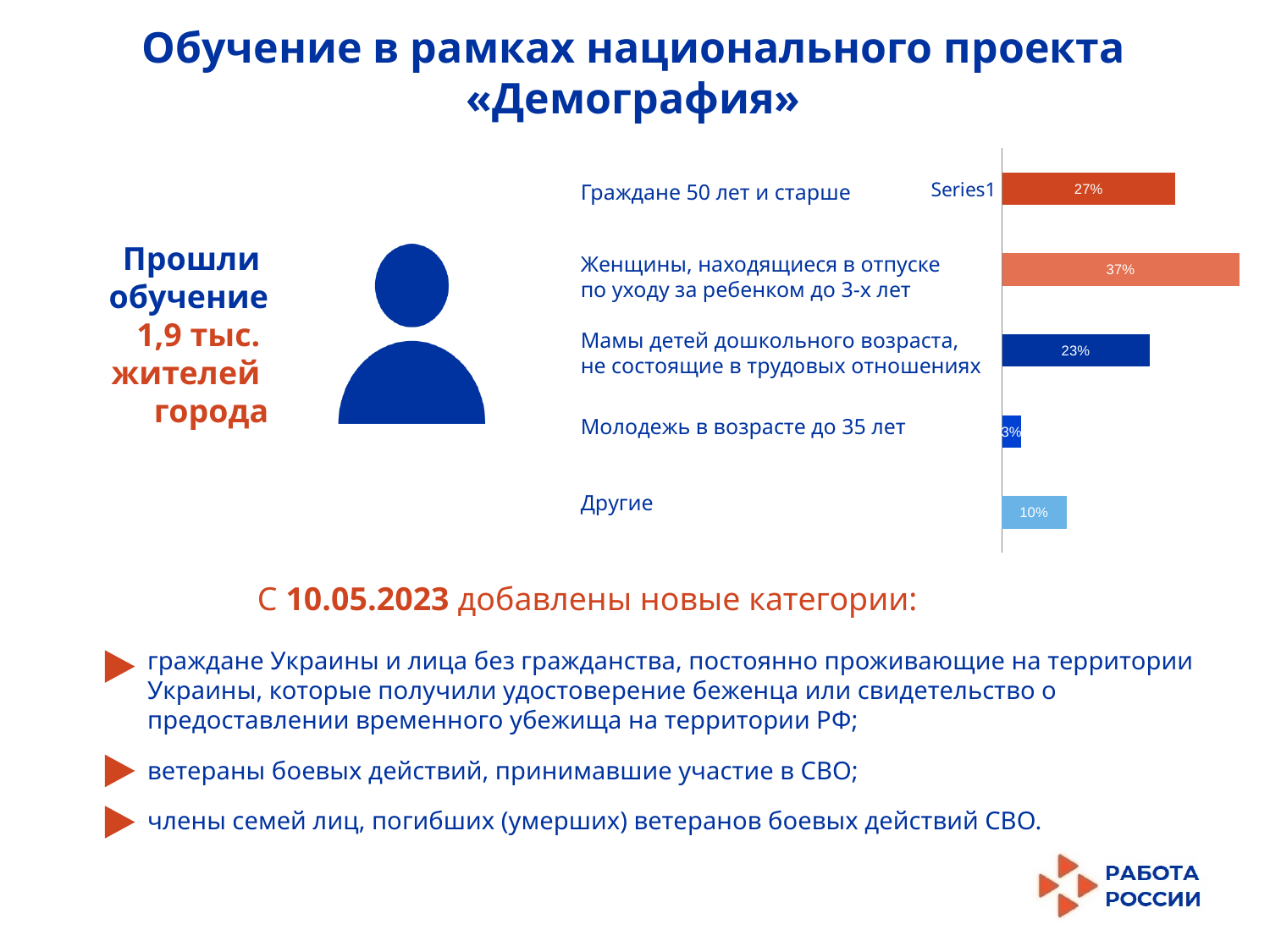
What series name is printed next to the top bar of the chart? Series1 Which category has the smallest share in the chart? Молодежь в возрасте до 35 лет What share is shown for "Мамы детей дошкольного возраста, не состоящие в трудовых отношениях"? 23% What is the difference between the shares for "Женщины, находящиеся в отпуске по уходу за ребенком до 3-х лет" and "Граждане 50 лет и старше"? 10% What share is shown for "Молодежь в возрасте до 35 лет"? 3% How many categories are plotted in the chart? 5 Which category has the largest share in the chart? Женщины, находящиеся в отпуске по уходу за ребенком до 3-х лет What share is shown for "Женщины, находящиеся в отпуске по уходу за ребенком до 3-х лет"? 37% What kind of chart is shown on the slide? Bar chart Which is larger: the share for "Граждане 50 лет и старше" or for "Мамы детей дошкольного возраста, не состоящие в трудовых отношениях"? Граждане 50 лет и старше What share is shown for the category "Граждане 50 лет и старше"? 27% What share is shown for the category "Другие"? 10%